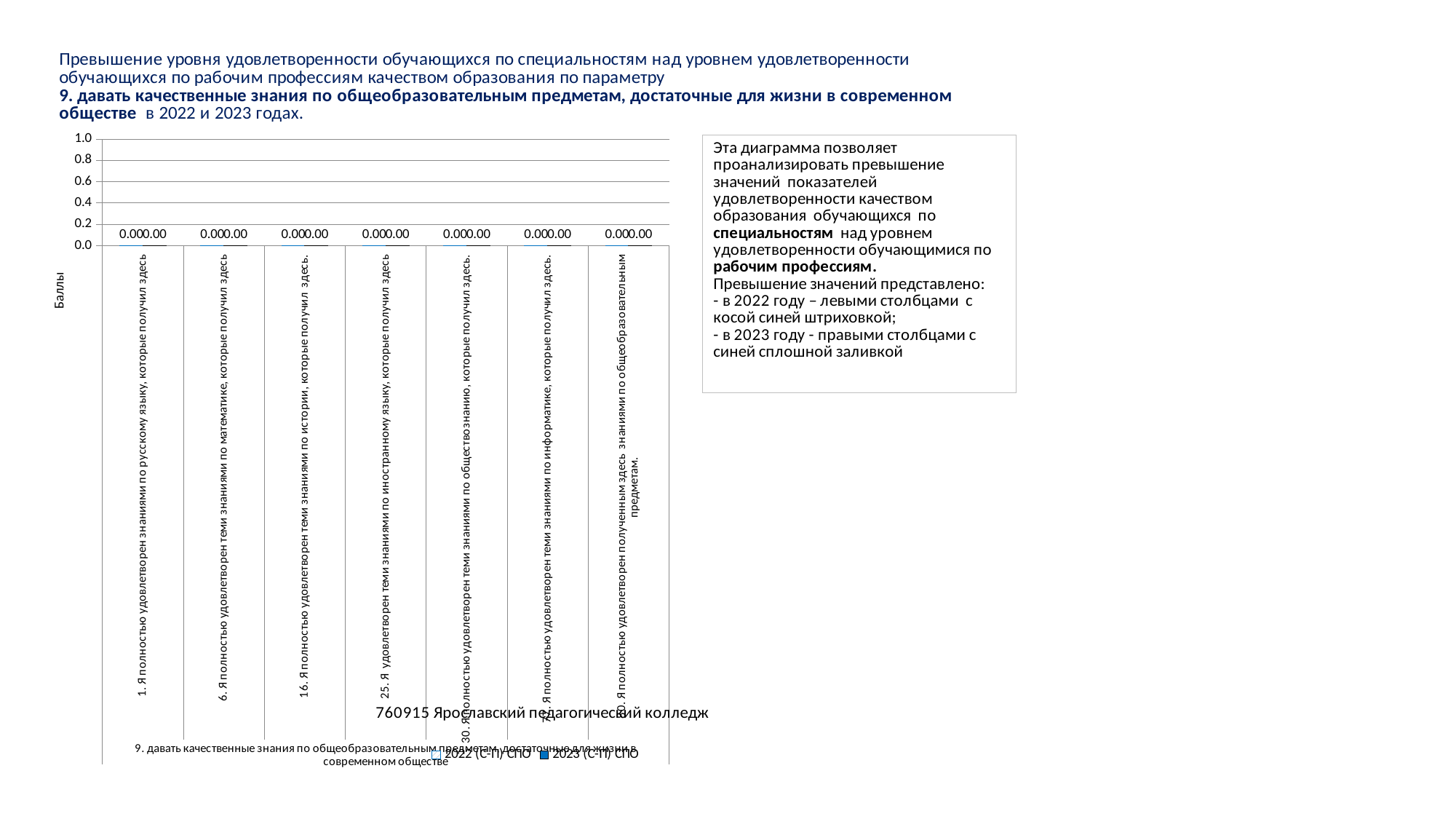
How many categories are plotted along the x axis of the chart? 7 What is the label of the vertical axis of the chart? Баллы Is the value for the category about knowledge of history (истории) greater or less than 0.2? less Do the values plotted in the chart rise, fall, or stay flat across the categories along the x axis? stay flat Is the value for the category about knowledge of mathematics (математике) greater or less than 0.4? less How many series does the chart legend list? 2 What are the two series named in the chart legend? 2022 (С-П) СПО and 2023 (С-П) СПО What is the highest tick value shown on the vertical axis? 1.0 What kind of chart is shown on the slide? bar chart Is the value for the category about knowledge of Russian language (русскому языку) greater or less than 0.2? less What data label is printed above the first category (русскому языку) in the chart? 0.00